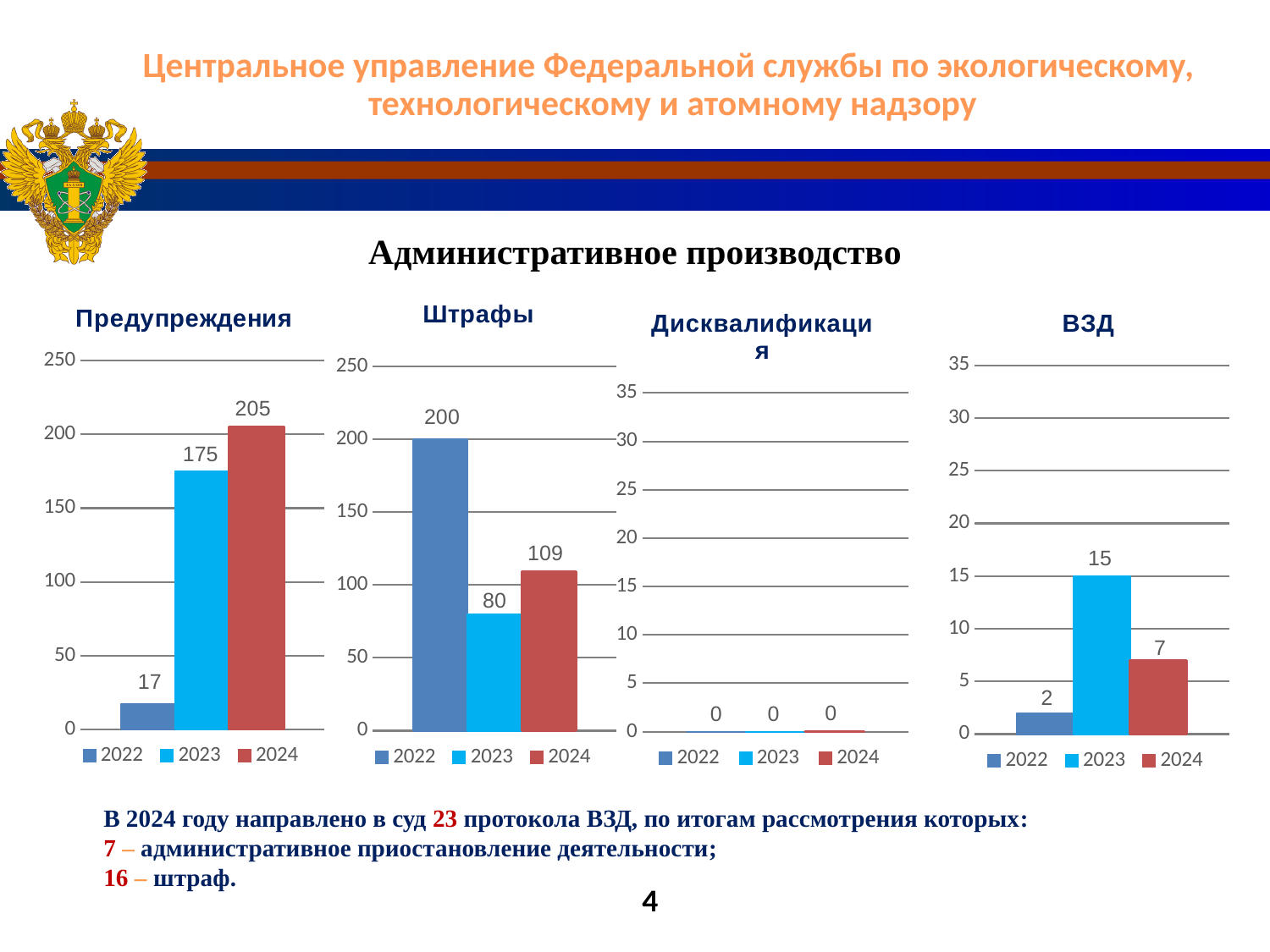
In the 'Предупреждения' chart, what is the difference between the values for 2024 and 2023? 30 What kind of chart is the 'ВЗД' chart? bar chart In the 'Предупреждения' chart, do the values rise or fall from 2022 to 2024? rise In the 'Штрафы' chart, what is the value for 2023? 80 In the 'ВЗД' chart, what is the value for 2022? 2 In the 'Предупреждения' chart, which year has the lowest value? 2022 How many series does the legend of the 'Дисквалификация' chart list? 3 In the 'Штрафы' chart, is the value for 2024 greater or less than 100? greater In the 'ВЗД' chart, is the value for 2023 larger or the value for 2024? 2023 In the 'Дисквалификация' chart, what is the value for 2024? 0 In the 'Предупреждения' chart, what is the value for 2024? 205 In the 'Штрафы' chart, which year has the highest value? 2022